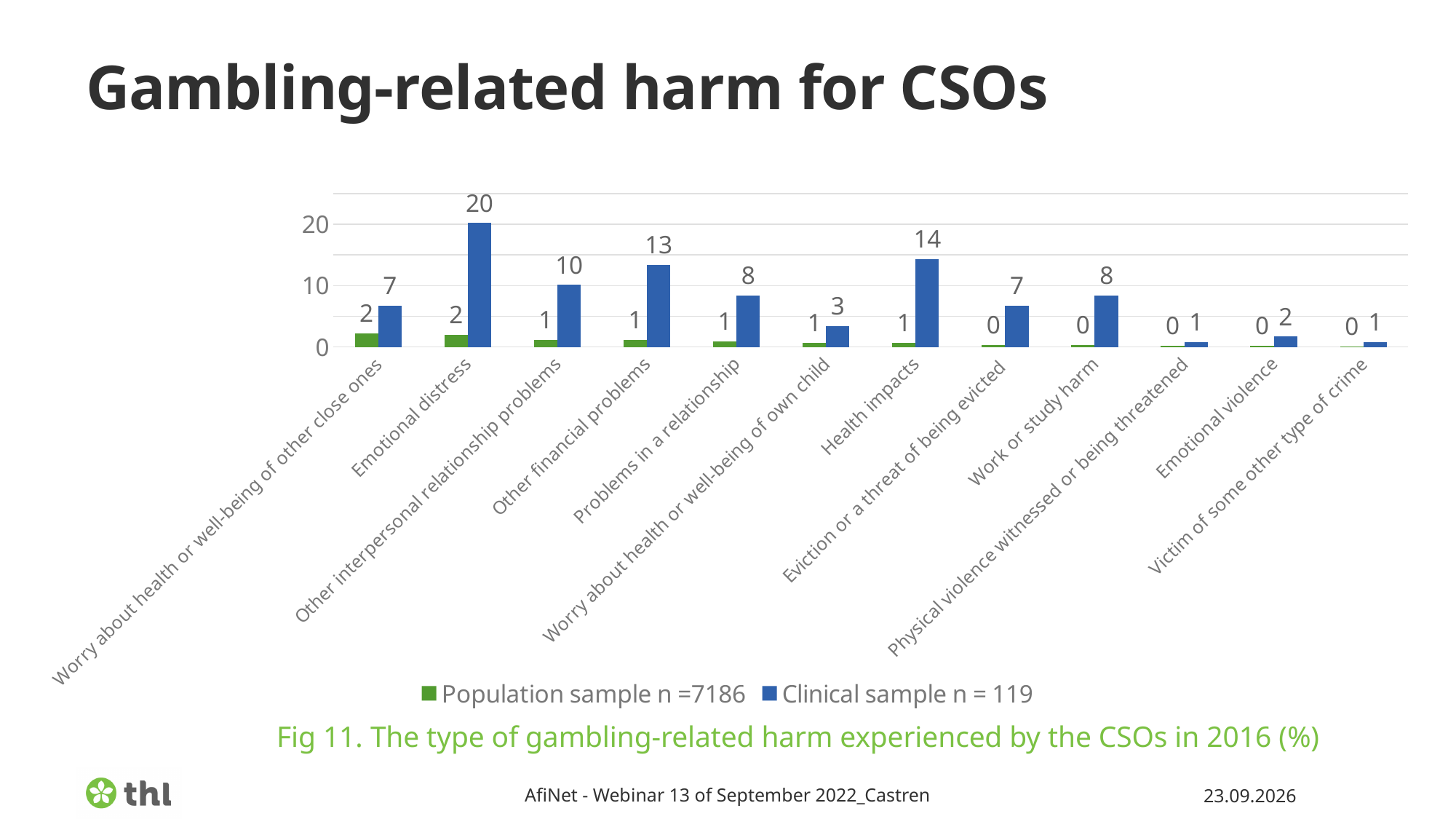
What is the sample size of the Clinical sample according to the legend? 119 Which category has the highest Clinical sample value? Emotional distress What is the Clinical sample value for Health impacts? 14 Which is larger for Work or study harm: the Clinical sample value or the Population sample value? Clinical sample Is the Clinical sample value for Emotional distress greater or less than 10? greater How many harm categories are shown on the x axis? 12 What is the Clinical sample value for Emotional distress? 20 What kind of chart is shown on the slide? Bar chart What is the Population sample value for Other financial problems? 1 How many series does the legend list? 2 What is the difference between the Clinical sample and Population sample values for Other financial problems? 12 What colour are the Population sample bars? Green